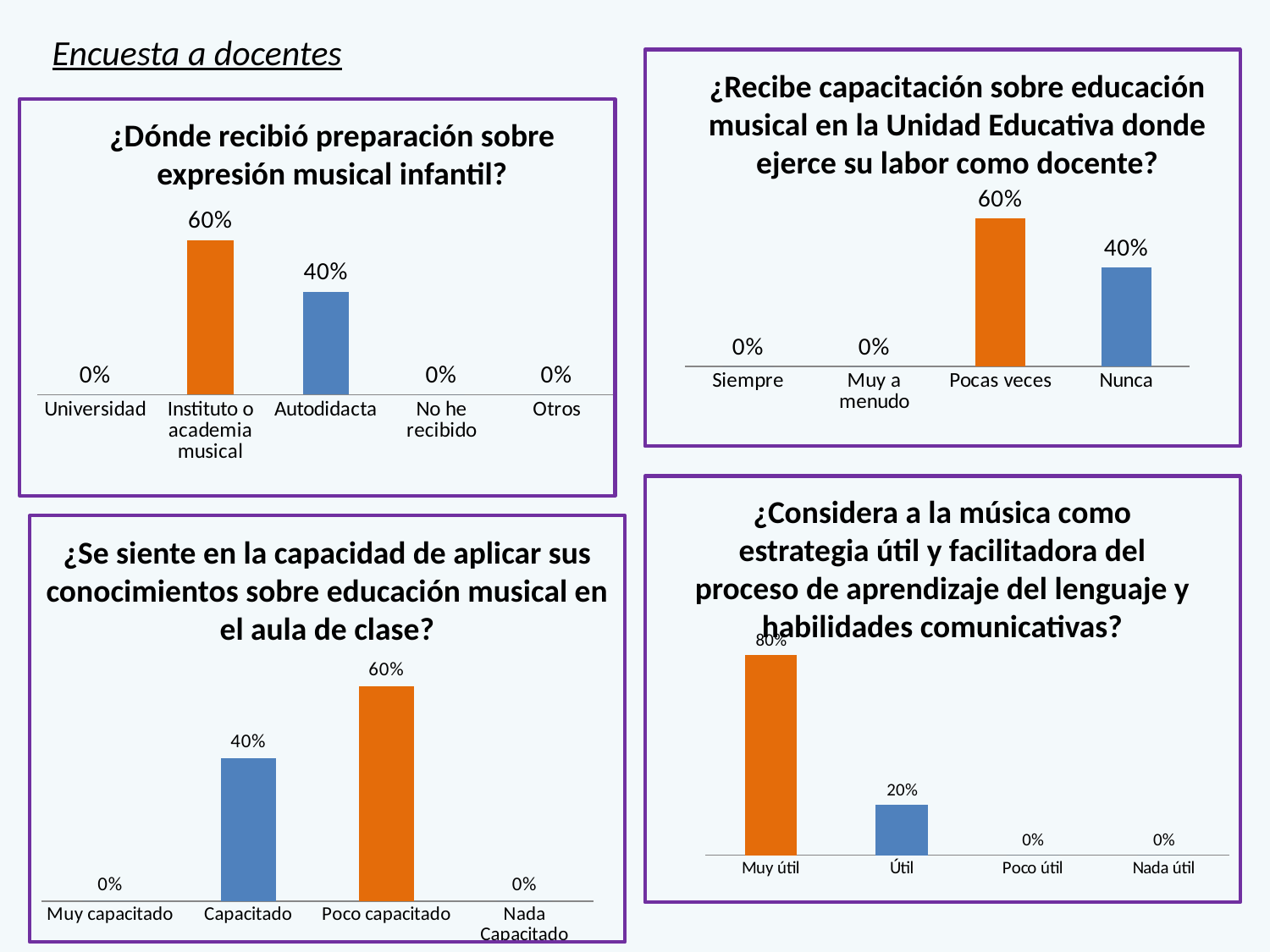
In the bottom-left chart '¿Se siente en la capacidad de aplicar sus conocimientos sobre educación musical en el aula de clase?', which is larger: 'Capacitado' or 'Poco capacitado'? Poco capacitado In the top-right chart '¿Recibe capacitación sobre educación musical en la Unidad Educativa donde ejerce su labor como docente?', what is the difference between 'Pocas veces' and 'Nunca'? 20% In the top-right chart '¿Recibe capacitación sobre educación musical en la Unidad Educativa donde ejerce su labor como docente?', what is the value for 'Nunca'? 40% In the bottom-right chart '¿Considera a la música como estrategia útil y facilitadora del proceso de aprendizaje del lenguaje y habilidades comunicativas?', what is the difference between 'Muy útil' and 'Útil'? 60% In the bottom-right chart '¿Considera a la música como estrategia útil y facilitadora del proceso de aprendizaje del lenguaje y habilidades comunicativas?', what is the value for 'Muy útil'? 80% In the top-left chart '¿Dónde recibió preparación sobre expresión musical infantil?', how many categories are shown on the x axis? 5 In the top-left chart '¿Dónde recibió preparación sobre expresión musical infantil?', what is the value for 'Instituto o academia musical'? 60% In the bottom-left chart '¿Se siente en la capacidad de aplicar sus conocimientos sobre educación musical en el aula de clase?', what is the value for 'Capacitado'? 40% In the top-left chart '¿Dónde recibió preparación sobre expresión musical infantil?', which category has the highest value? Instituto o academia musical In the bottom-left chart '¿Se siente en la capacidad de aplicar sus conocimientos sobre educación musical en el aula de clase?', which category has the highest value? Poco capacitado In the top-right chart '¿Recibe capacitación sobre educación musical en la Unidad Educativa donde ejerce su labor como docente?', what is the value for 'Siempre'? 0% What kind of chart is the bottom-right chart '¿Considera a la música como estrategia útil y facilitadora del proceso de aprendizaje del lenguaje y habilidades comunicativas?'? Bar chart